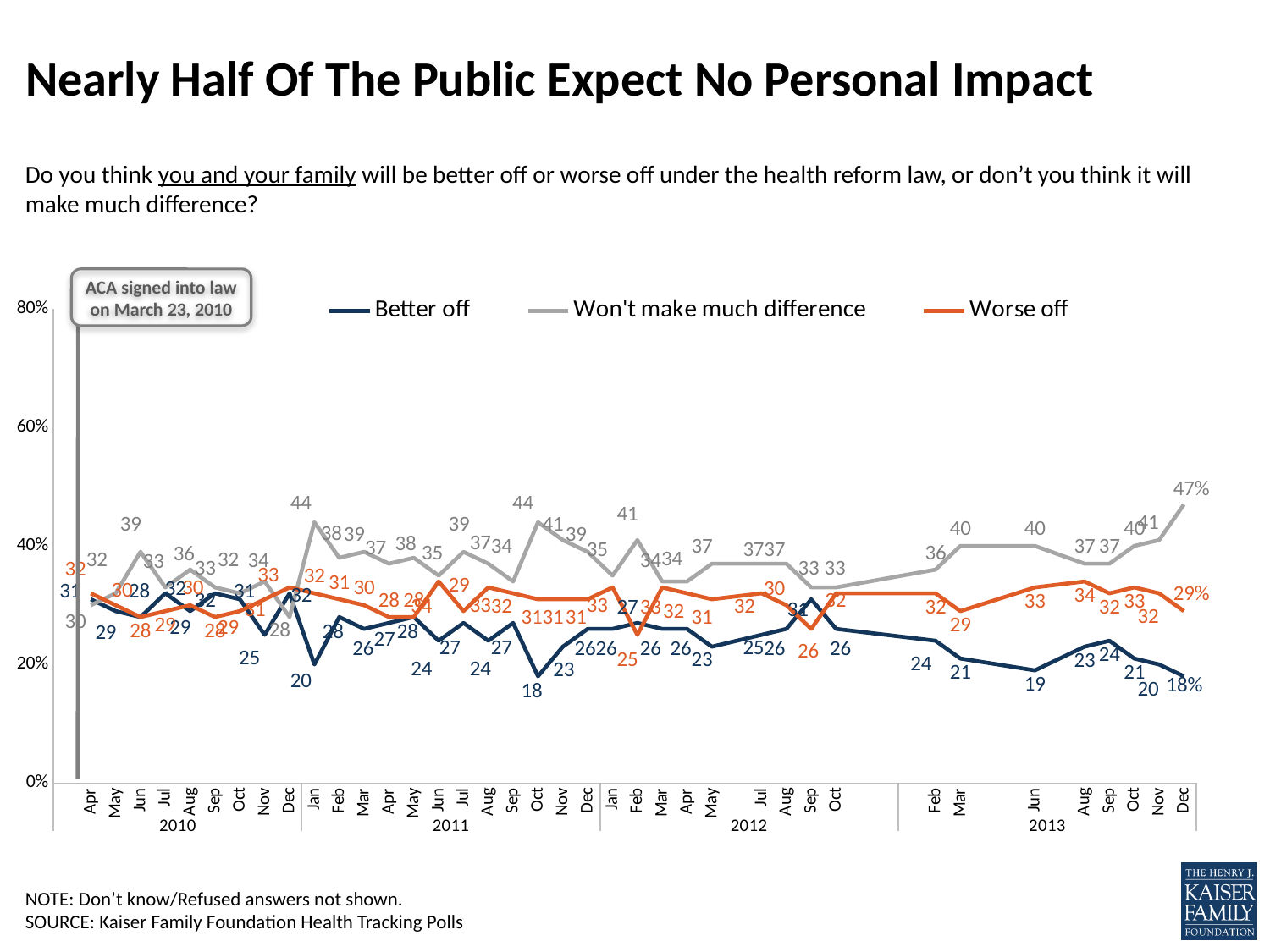
What is the value for 'Won't make much difference' in Dec 2013? 47% What is the value for 'Better off' in Jan 2011? 20 What does the annotation box at the top left of the chart say? ACA signed into law on March 23, 2010 What is the highest value shown for 'Won't make much difference'? 47% What is the difference between 'Won't make much difference' and 'Better off' in Dec 2013? 29 What is the value for 'Worse off' in Dec 2013? 29% How many series does the legend list? 3 Does the 'Better off' line rise or fall from Sep 2013 to Dec 2013? fall Is the value for 'Won't make much difference' in Dec 2013 greater or less than 40%? greater In Dec 2013, which is larger: 'Better off' or 'Worse off'? Worse off What type of chart is shown on the slide? line chart What is the value for 'Better off' in Dec 2013? 18%